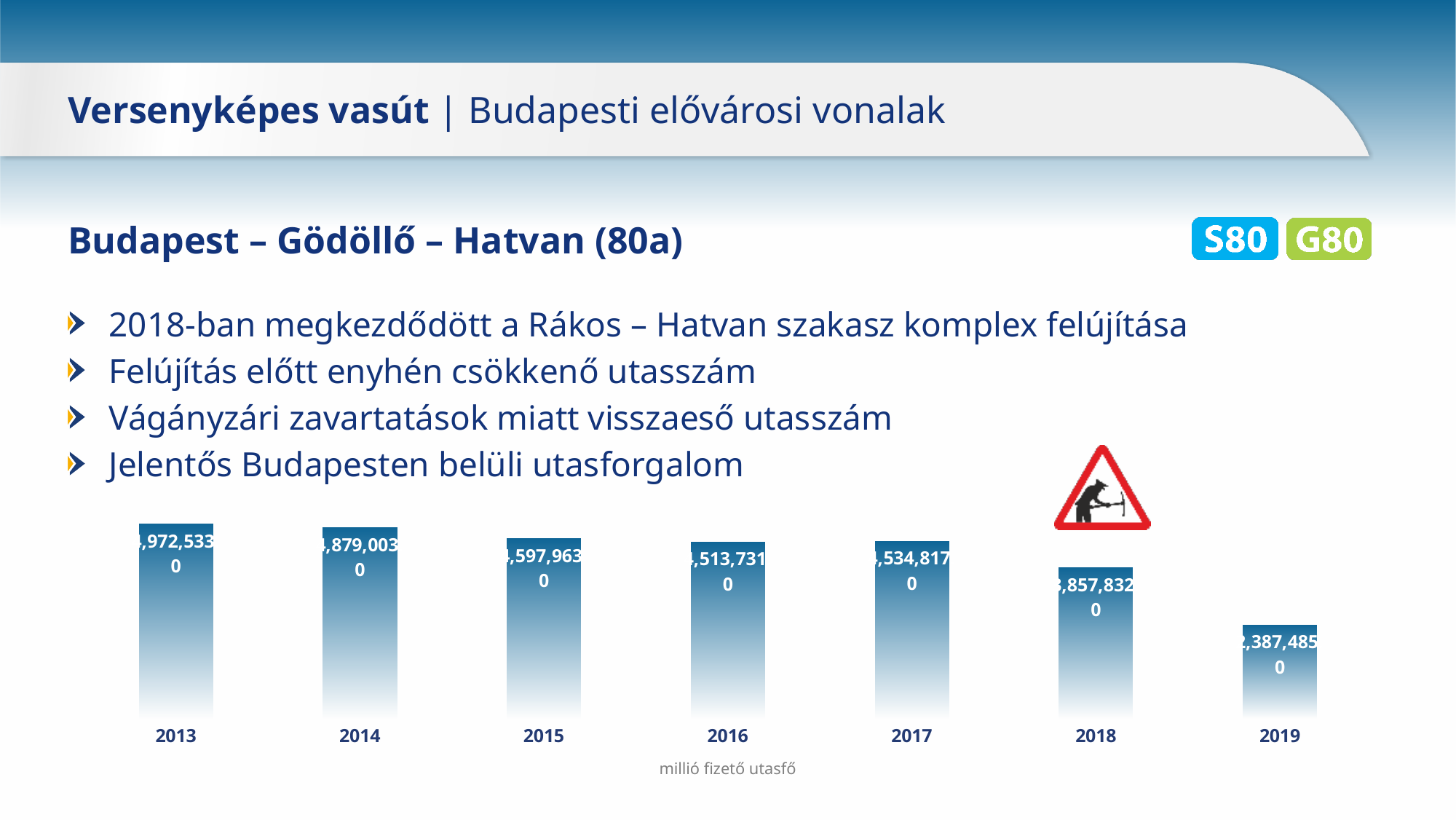
What unit label is printed below the chart? millió fizető utasfő Which year has the larger value, 2018 or 2019? 2018 What is the first year shown on the x axis of the chart? 2013 Which year has the larger value, 2017 or 2018? 2017 Which year has the highest bar in the chart? 2013 Which year has the larger value, 2014 or 2015? 2014 Do the values generally rise or fall from 2013 to 2019? fall Which year has the lowest bar in the chart? 2019 What kind of chart is shown on the slide? bar chart How many years are plotted in the chart? 7